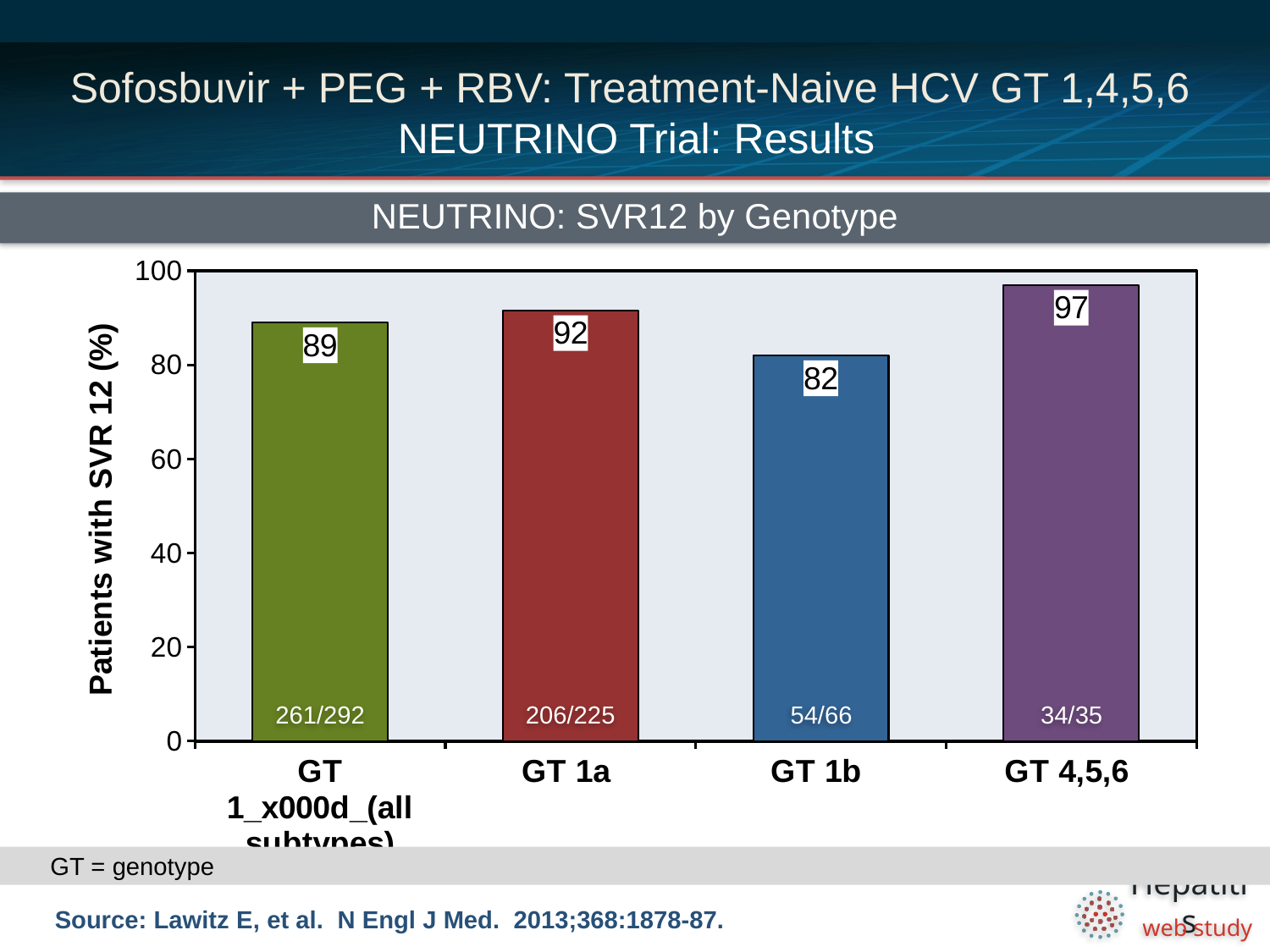
What type of chart is shown on the slide? Bar chart Which has a higher SVR12 rate, GT 1a or GT 1b? GT 1a What is the SVR12 rate shown for GT 1a? 92 Which genotype group has the highest SVR12 rate? GT 4,5,6 What patient fraction is printed inside the GT 1b bar? 54/66 How many genotype groups are plotted in the chart? 4 What is the SVR12 rate shown for GT 1b? 82 What is the SVR12 rate shown for the first bar, GT 1 (all subtypes)? 89 What is the title of the chart? NEUTRINO: SVR12 by Genotype What is the difference in SVR12 rate between GT 4,5,6 and GT 1b? 15 What is the SVR12 rate shown for GT 4,5,6? 97 Which genotype group has the lowest SVR12 rate? GT 1b